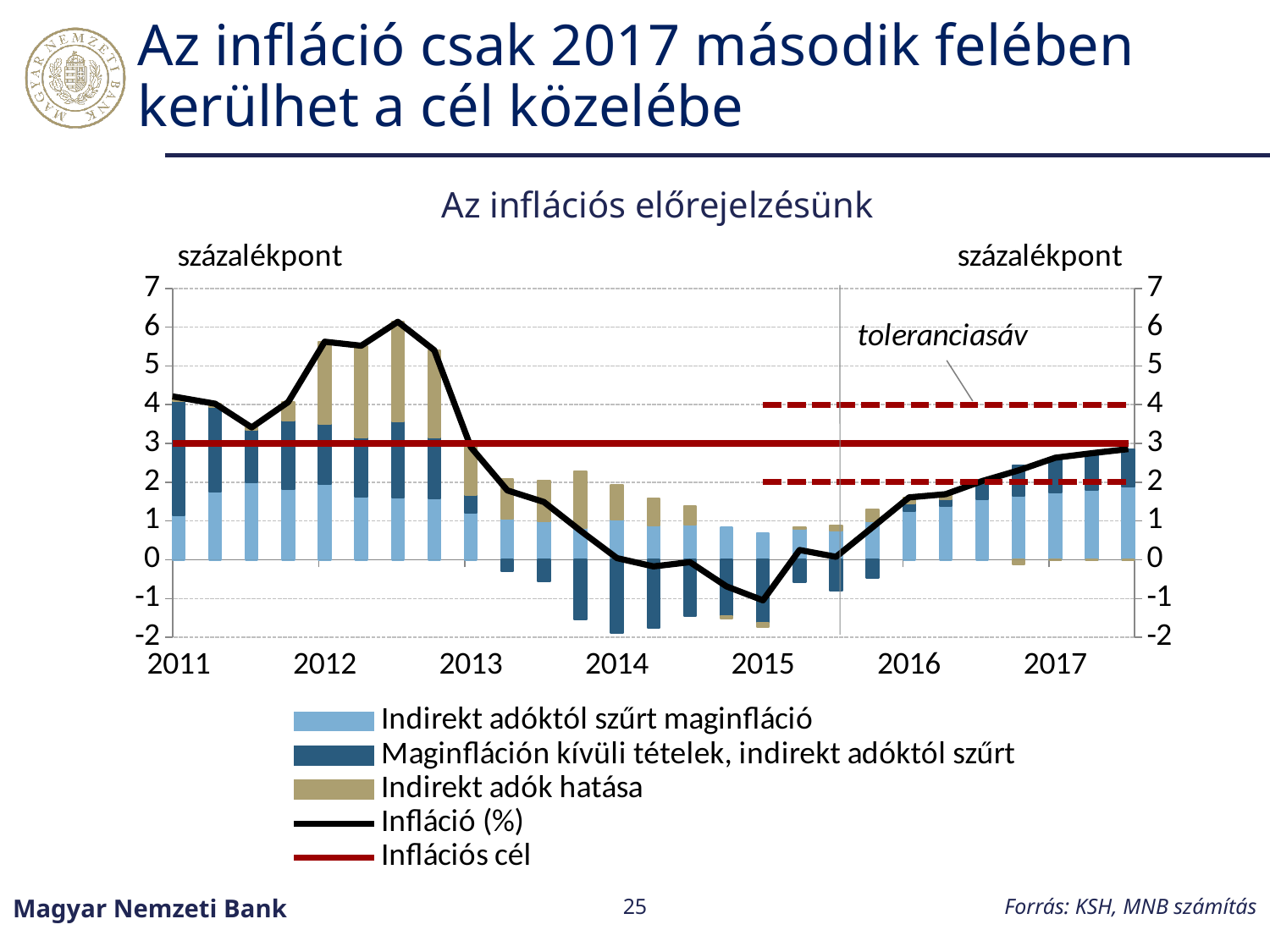
What is the title of the chart? Az inflációs előrejelzésünk Is the peak value of the Infláció (%) line in 2012 greater or less than 5? greater Between which two values on the vertical axis do the dashed lines of the toleranciasáv lie? 2 and 4 Is the value of the Infláció (%) line at the start of 2015 greater or less than 0? less What kind of chart is shown on the slide? A combined stacked bar and line chart What unit is shown on the vertical axes of the chart? százalékpont How many years are labelled on the horizontal axis? 7 In which year does the Infláció (%) line reach its highest point? 2012 In which year does the Infláció (%) line reach its lowest point? 2015 How many series does the legend list? 5 At what value does the Inflációs cél line sit on the vertical axis? 3 Does the Infláció (%) line rise or fall between 2015 and 2017? rise